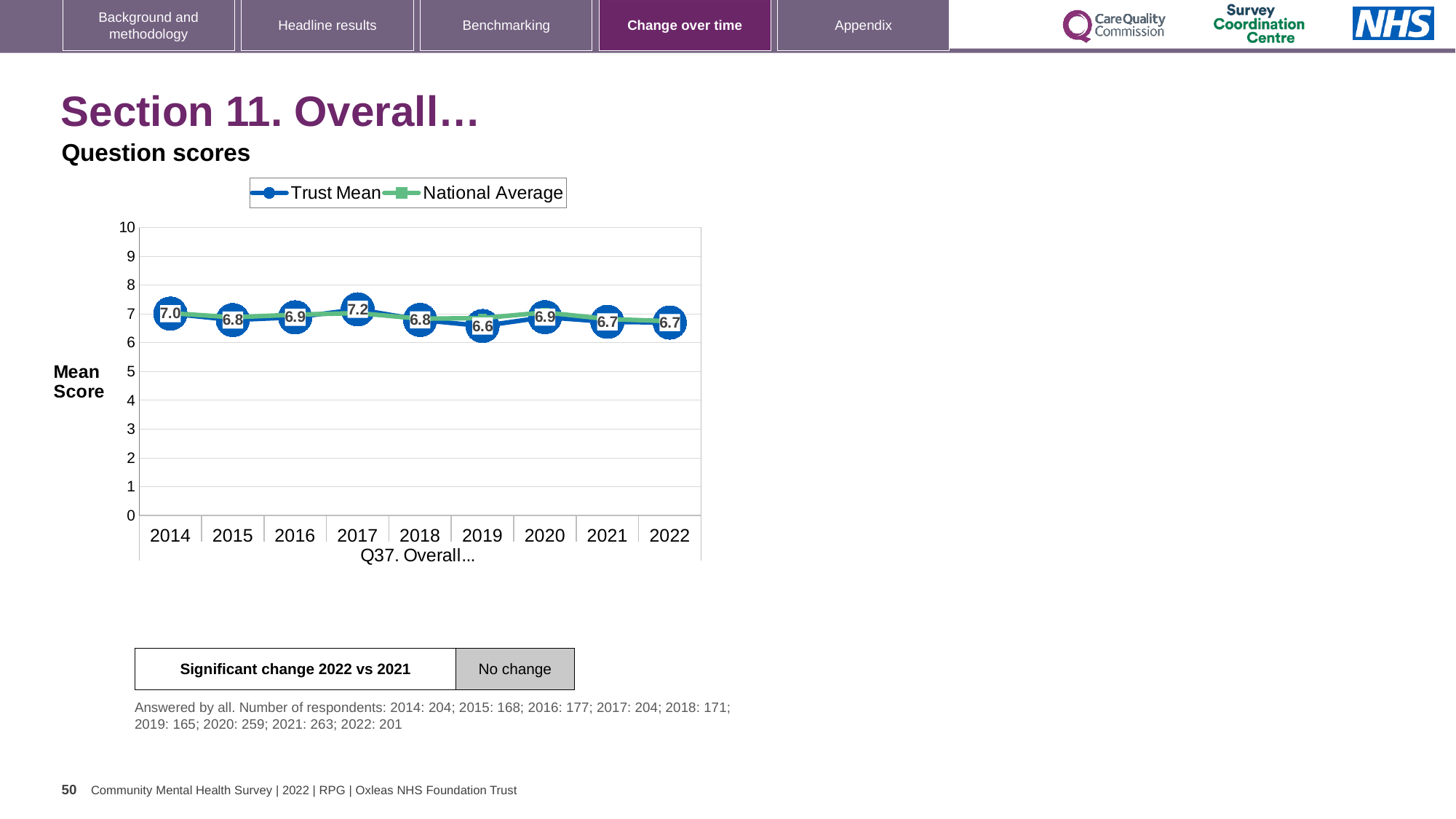
What is the Trust Mean value for 2019? 6.6 In which year is the Trust Mean lowest? 2019 Does the Trust Mean rise or fall from 2017 to 2019? Fall How many years are shown on the x axis? 9 What is the Trust Mean value for 2017? 7.2 Is the National Average value for 2018 greater or less than 5? greater How many series does the legend list? 2 Which is larger, the Trust Mean for 2014 or for 2015? 2014 What is the Trust Mean value for 2022? 6.7 In which year is the Trust Mean highest? 2017 What is the difference between the Trust Mean in 2017 and in 2019? 0.6 What kind of chart is shown on the slide? Line chart